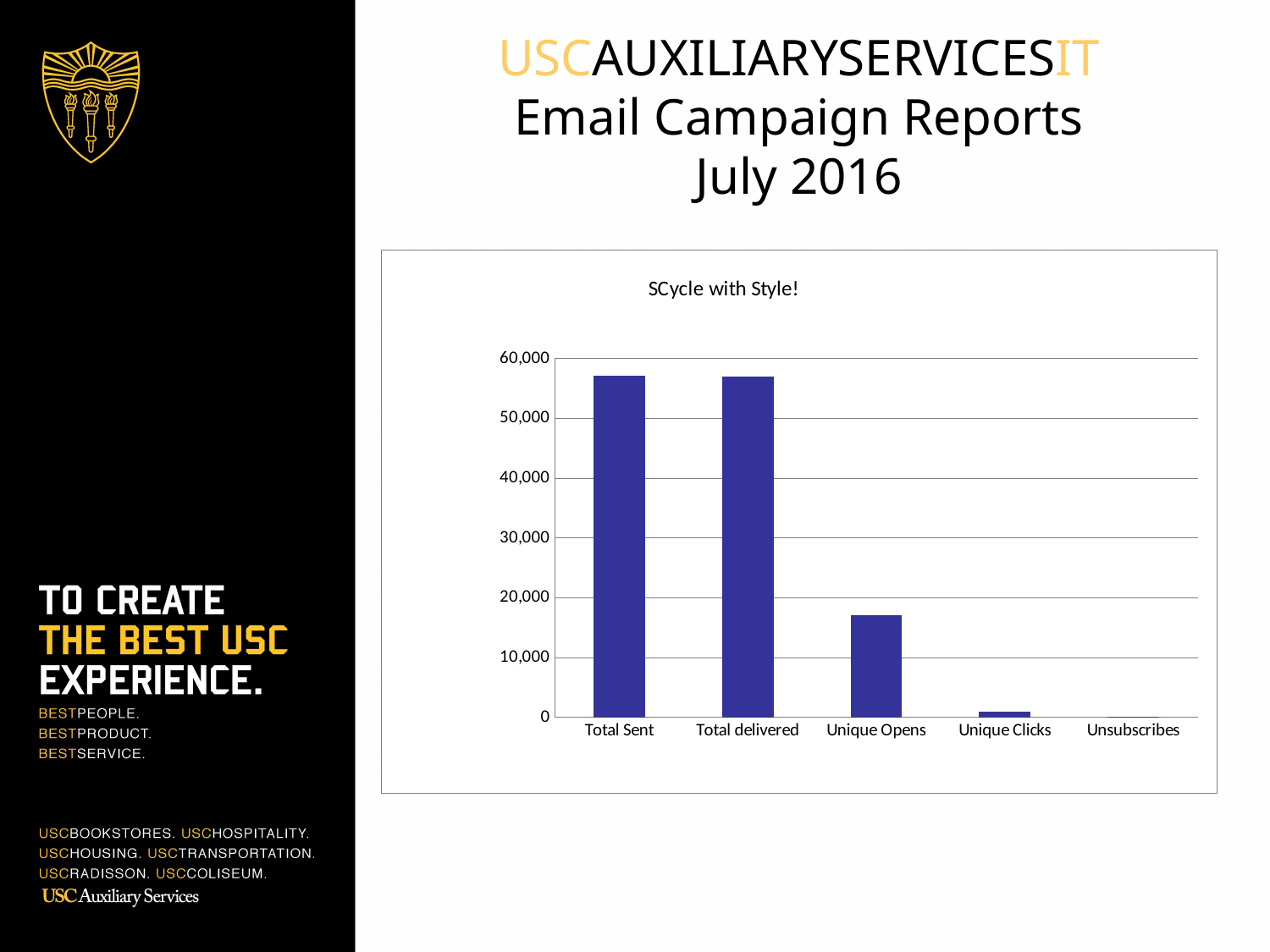
Is the value for Total Sent greater or less than 50,000? greater What is the title of the chart? SCycle with Style! Is the value for Unique Clicks greater or less than 10,000? less Is the value for Unique Opens greater or less than 10,000? greater Which is larger, the value for Unique Clicks or the value for Unique Opens? Unique Opens How many categories are shown on the x axis of the chart? 5 What kind of chart is shown on the slide? bar chart Do the values rise or fall moving from left to right along the x axis? fall Which category has the lowest value in the chart? Unsubscribes Which is larger, the value for Total Sent or the value for Unique Opens? Total Sent